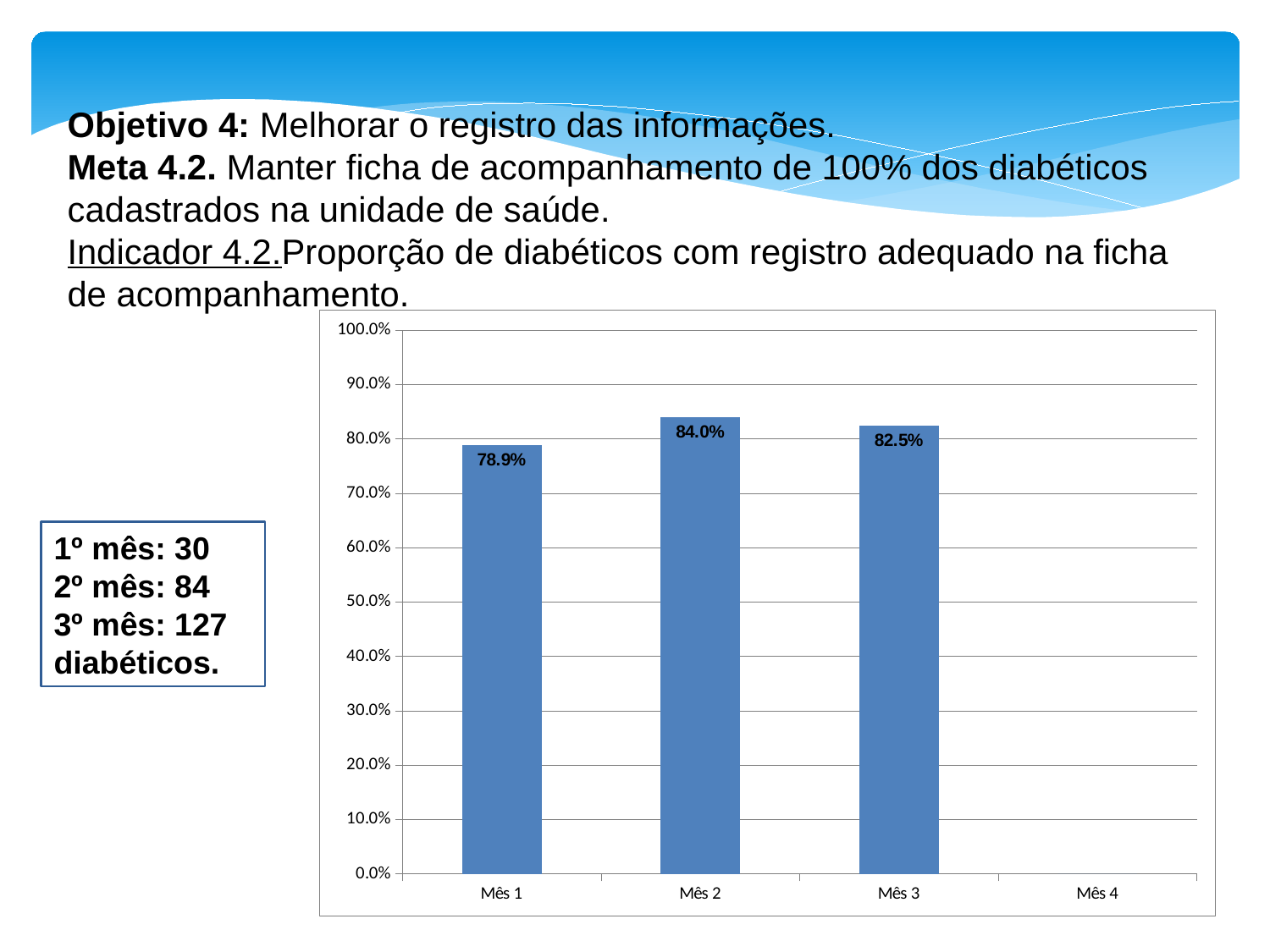
How many bars are plotted in the chart? 3 What is the difference between the values for Mês 2 and Mês 3? 1.5 percentage points What is the value for Mês 3? 82.5% Which month has the lowest plotted value? Mês 1 What is the value for Mês 2? 84.0% Which is larger, the value for Mês 3 or the value for Mês 1? Mês 3 Does the value rise or fall from Mês 2 to Mês 3? fall Is the value for Mês 1 greater or less than 80.0%? less Which month has the highest value? Mês 2 What is the difference between the values for Mês 2 and Mês 1? 5.1 percentage points What kind of chart is shown on the slide? bar chart What is the value for Mês 1? 78.9%